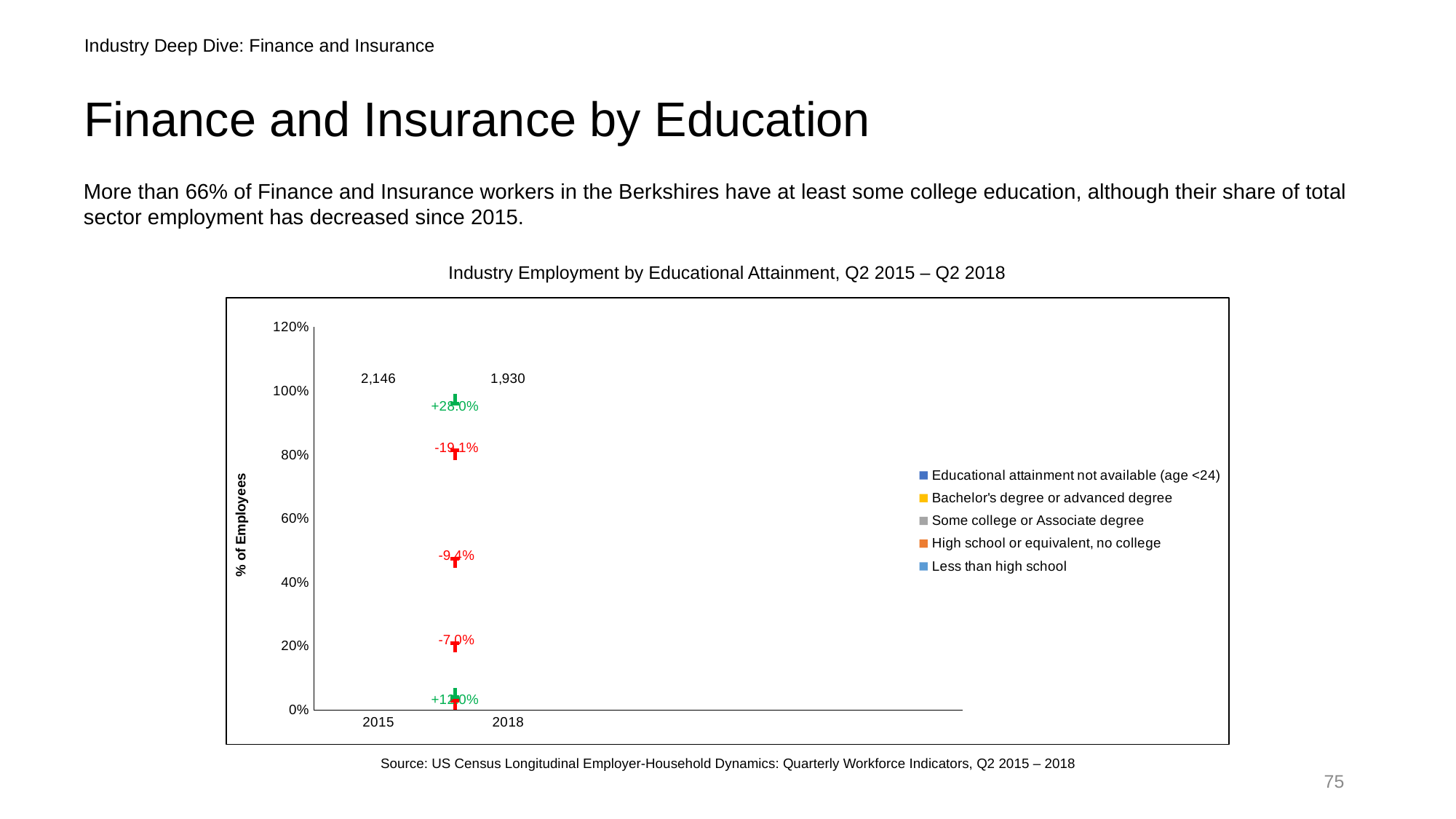
How many series does the chart legend list? 5 Which year has the larger total employment label, 2015 or 2018? 2015 What total employment figure is labelled above the 2018 column? 1,930 How many years are shown on the x axis of the chart? 2 What is the highest value shown on the vertical axis? 120% What is the title of the chart? Industry Employment by Educational Attainment, Q2 2015 – Q2 2018 What percentage change label is shown in red near the 45% level of the chart? -9.4% What is the difference between the 2015 total (2,146) and the 2018 total (1,930)? 216 What total employment figure is labelled above the 2015 column? 2,146 What is the most negative percentage change label shown between the two years? -19.1% What is the label on the vertical axis of the chart? % of Employees What percentage change label is shown in red near the 20% level of the chart? -7.0%